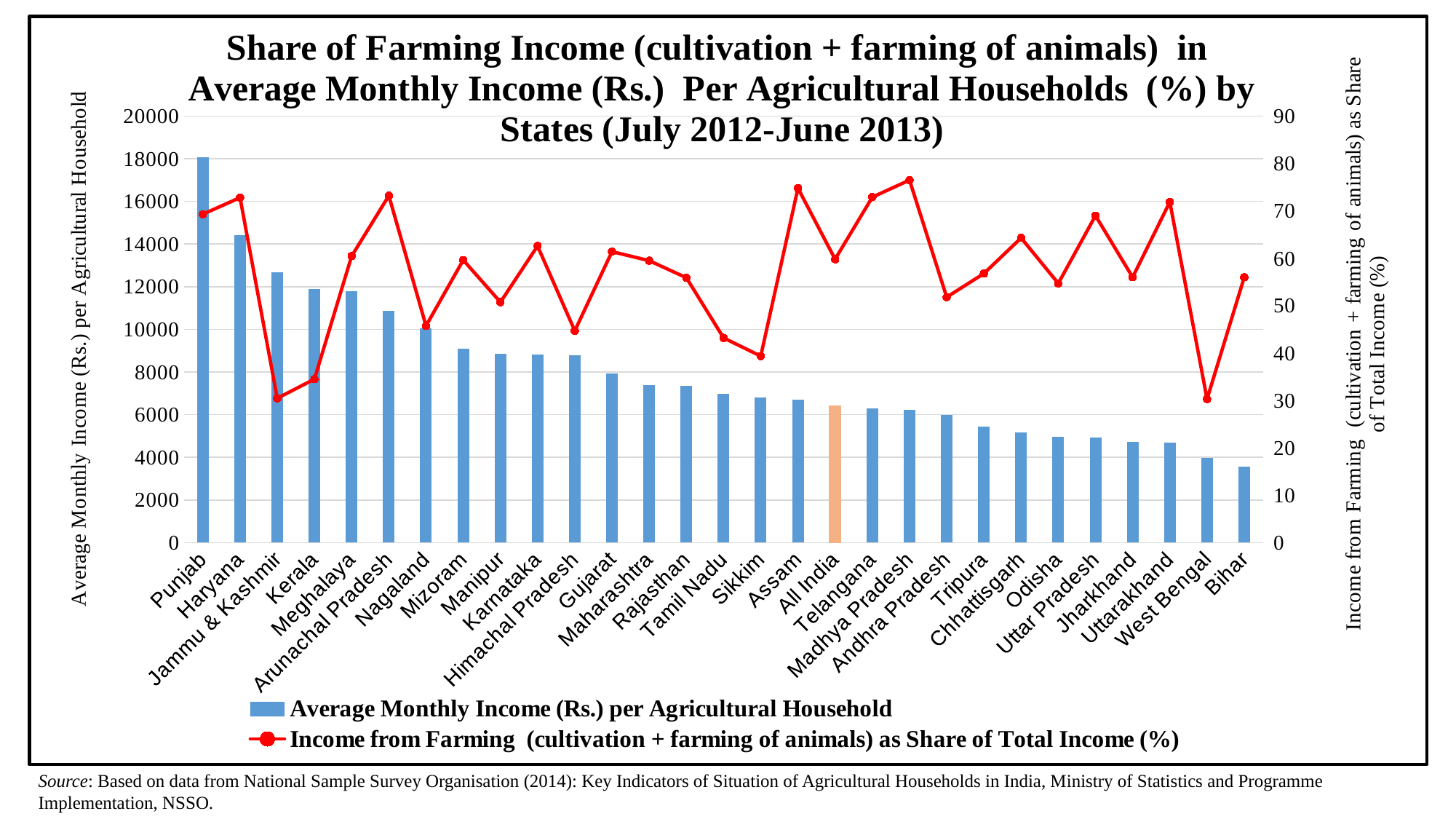
What kind of chart is shown on the slide? A combination bar and line chart Which has a higher Average Monthly Income per Agricultural Household, Punjab or Haryana? Punjab Is the Average Monthly Income per Agricultural Household for Punjab greater or less than 16000? greater How many series does the legend list? 2 Is the Income from Farming as Share of Total Income (%) for Sikkim greater or less than 50? less Is the Income from Farming as Share of Total Income (%) for Arunachal Pradesh greater or less than 70? greater Do the Average Monthly Income bars rise or fall moving from left to right along the x axis? fall Which has a higher Income from Farming as Share of Total Income (%), Sikkim or Arunachal Pradesh? Arunachal Pradesh How many states/categories are plotted along the x axis? 29 Which state has the lowest Average Monthly Income (Rs.) per Agricultural Household? Bihar Which state has the highest Average Monthly Income (Rs.) per Agricultural Household? Punjab